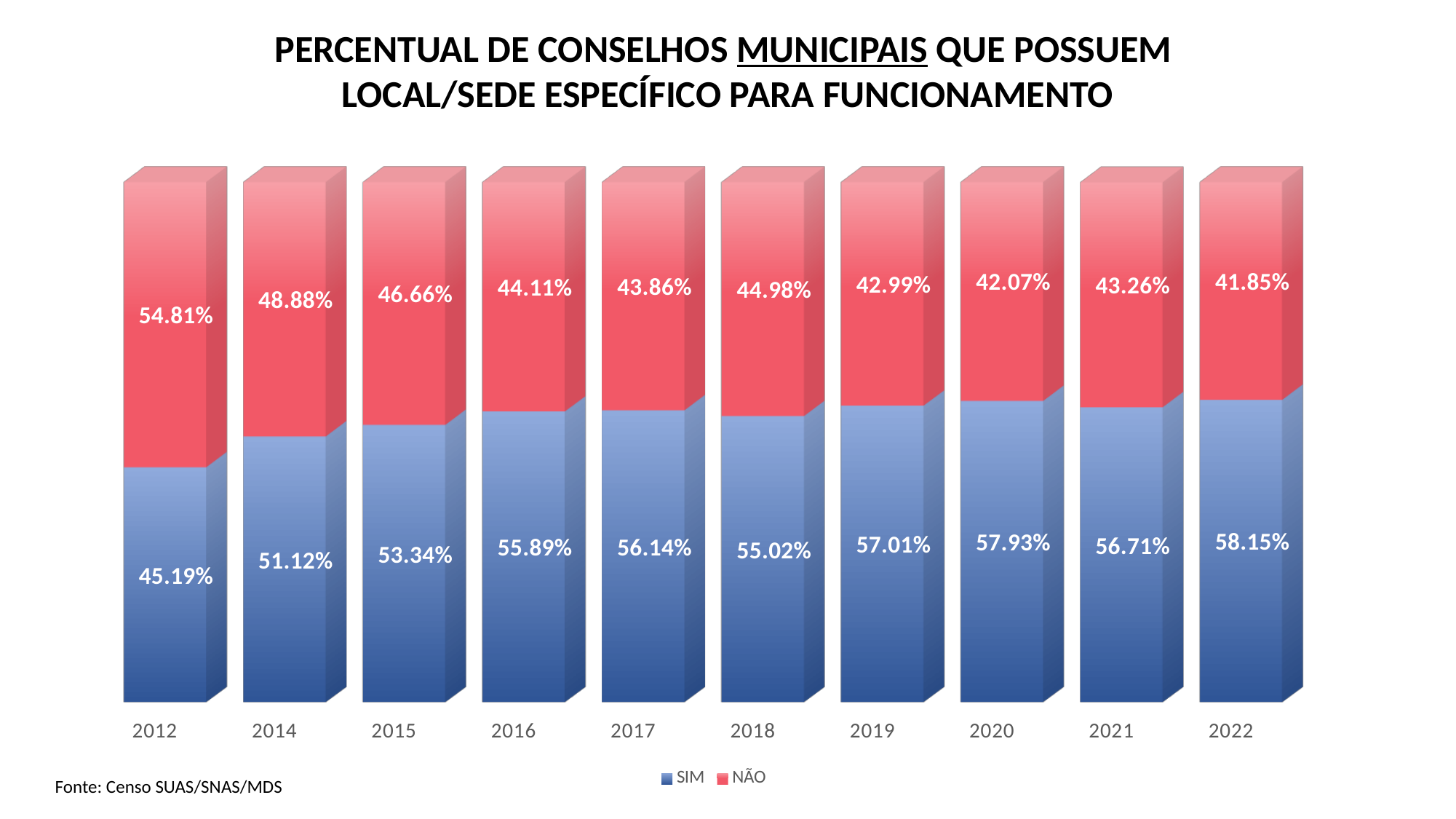
Is the SIM value for 2018 larger than the SIM value for 2019? No Which year has the highest SIM value? 2022 What is the SIM value for 2012? 45.19% What is the NÃO value for 2020? 42.07% What is the SIM value for 2022? 58.15% What kind of chart is shown on the slide? Stacked bar chart What is the difference between the SIM values for 2022 and 2012? 12.96% Which colour represents the NÃO series? Red Which year has the lowest SIM value? 2012 How many years are shown on the x axis? 10 Which year has the highest NÃO value? 2012 How many series does the legend list? 2